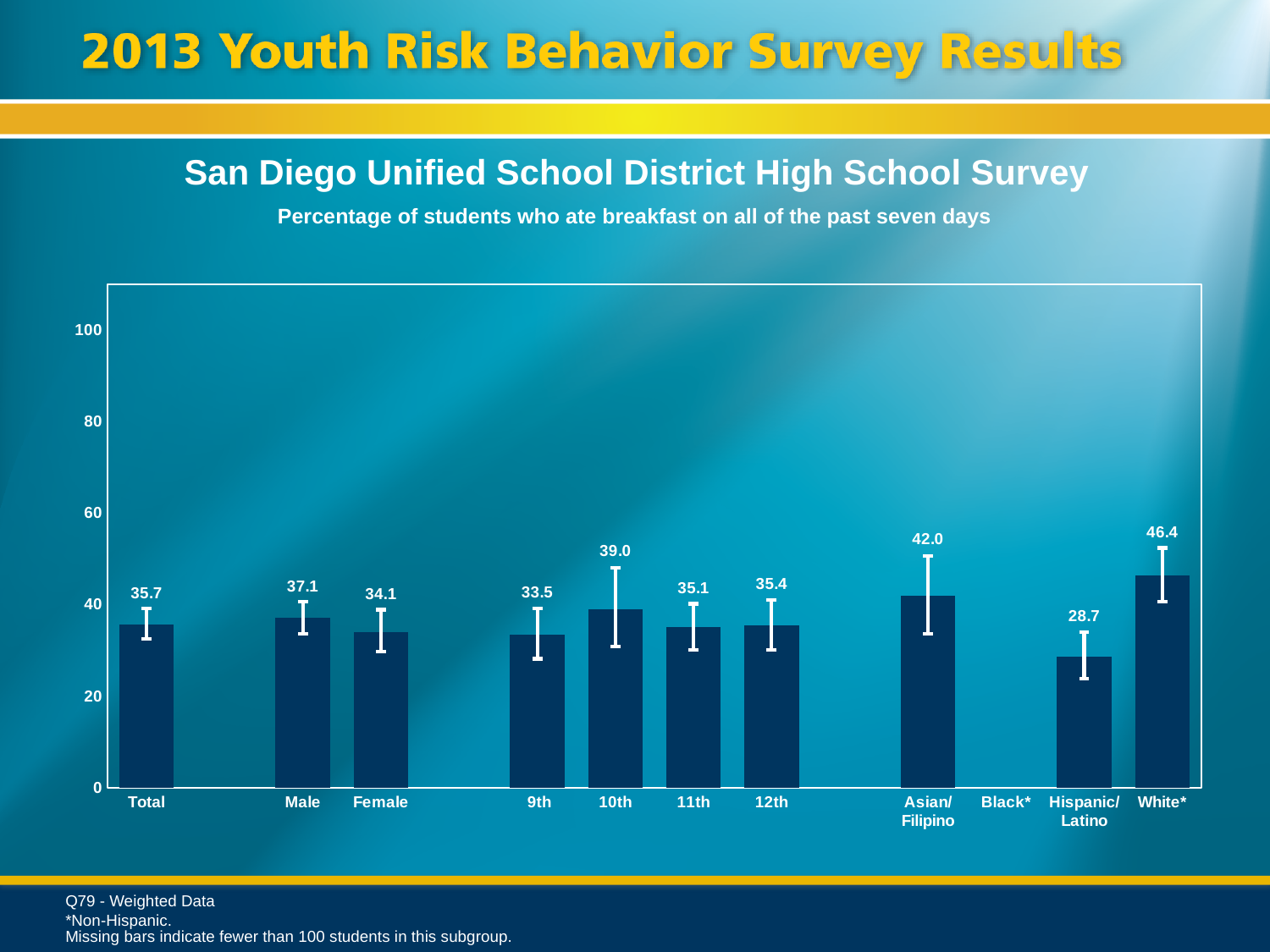
What is the value for Total? 35.7 How many categories have a bar plotted? 10 Do the values rise or fall from 9th grade to 10th grade? rise What is the value for Hispanic/Latino? 28.7 Which category has the lowest value among those with bars? Hispanic/Latino Which category has the highest value? White* What is the difference between the Male and Female values? 3.0 What kind of chart is shown? bar chart Which category has no bar shown? Black* Is the value for White* greater or less than 40? greater What is the value for 10th grade? 39.0 Which is larger, the value for Asian/Filipino or the value for 12th grade? Asian/Filipino